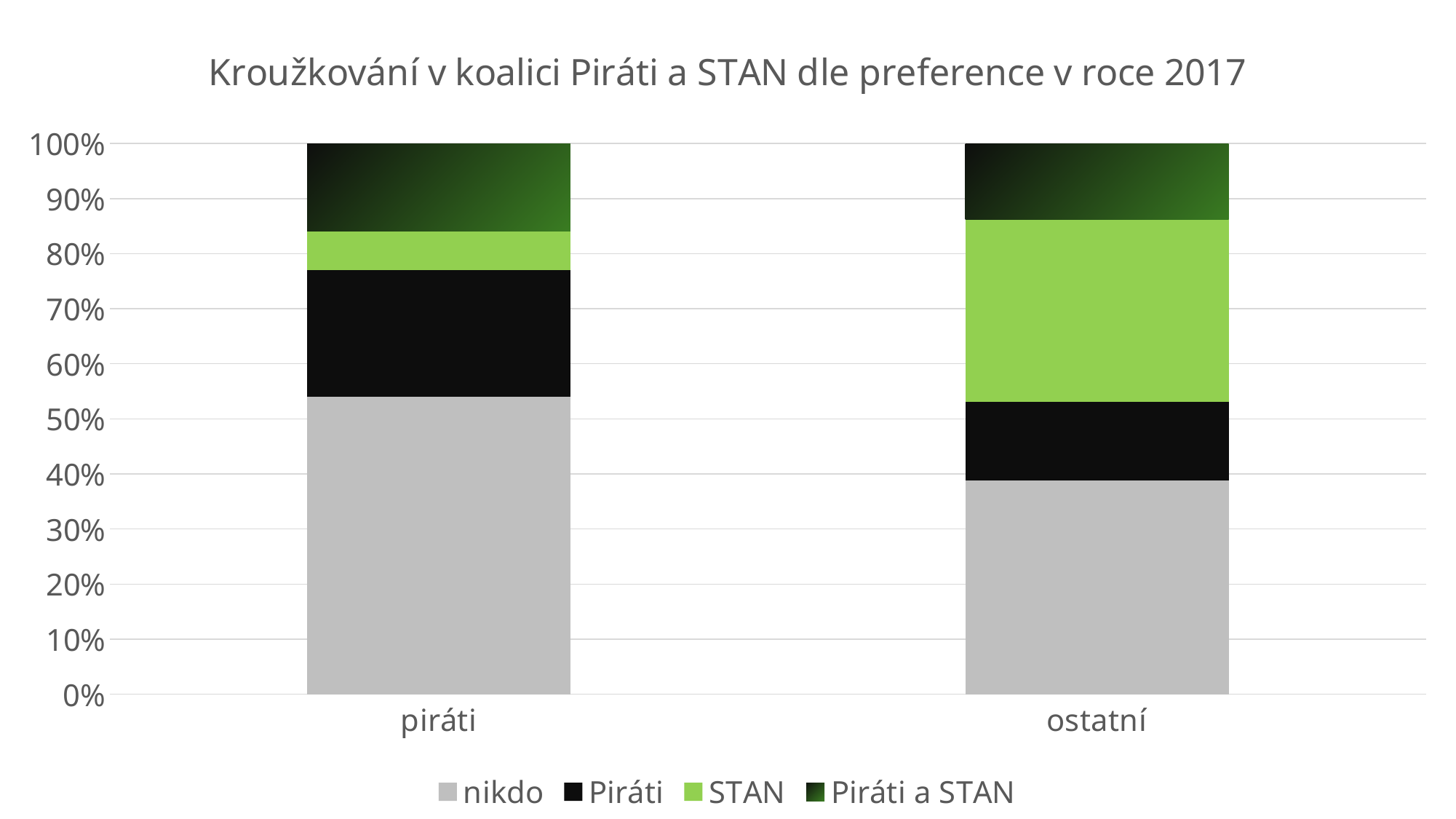
Is the STAN share for ostatní greater or less than 20%? greater What kind of chart is shown on the slide? stacked bar chart Which series is the smallest segment in the piráti bar? STAN Which category has the larger STAN share, piráti or ostatní? ostatní Is the Piráti a STAN share for piráti greater or less than 20%? less Is the nikdo share for ostatní greater or less than 50%? less Which series is shown in light green in the legend? STAN How many categories are shown on the x axis? 2 What is the total height of the stacked bar for piráti? 100% How many series does the legend list? 4 What is the title of the chart? Kroužkování v koalici Piráti a STAN dle preference v roce 2017